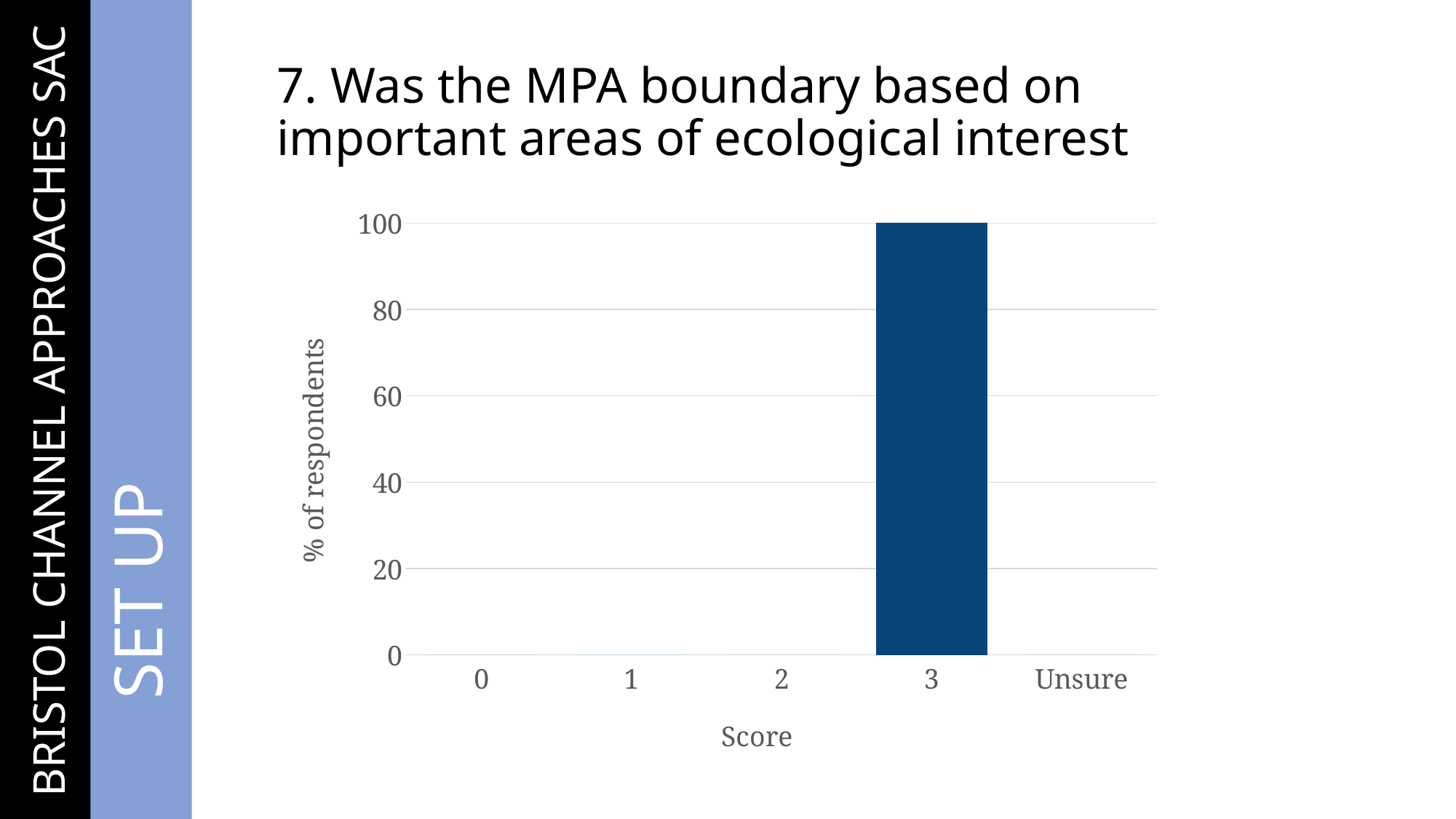
What is the label of the y axis? % of respondents What is the % of respondents for score 3? 100 What is the difference between the value for score 3 and the value for score 2? 100 Which is larger, the value for score 3 or the value for Unsure? 3 Is the value for score 3 greater or less than 80? greater What is the % of respondents for score 0? 0 What kind of chart is shown on the slide? bar chart How many score categories are shown on the x axis? 5 What is the label of the x axis? Score What is the highest value shown on the y axis? 100 Which score category has the highest % of respondents? 3